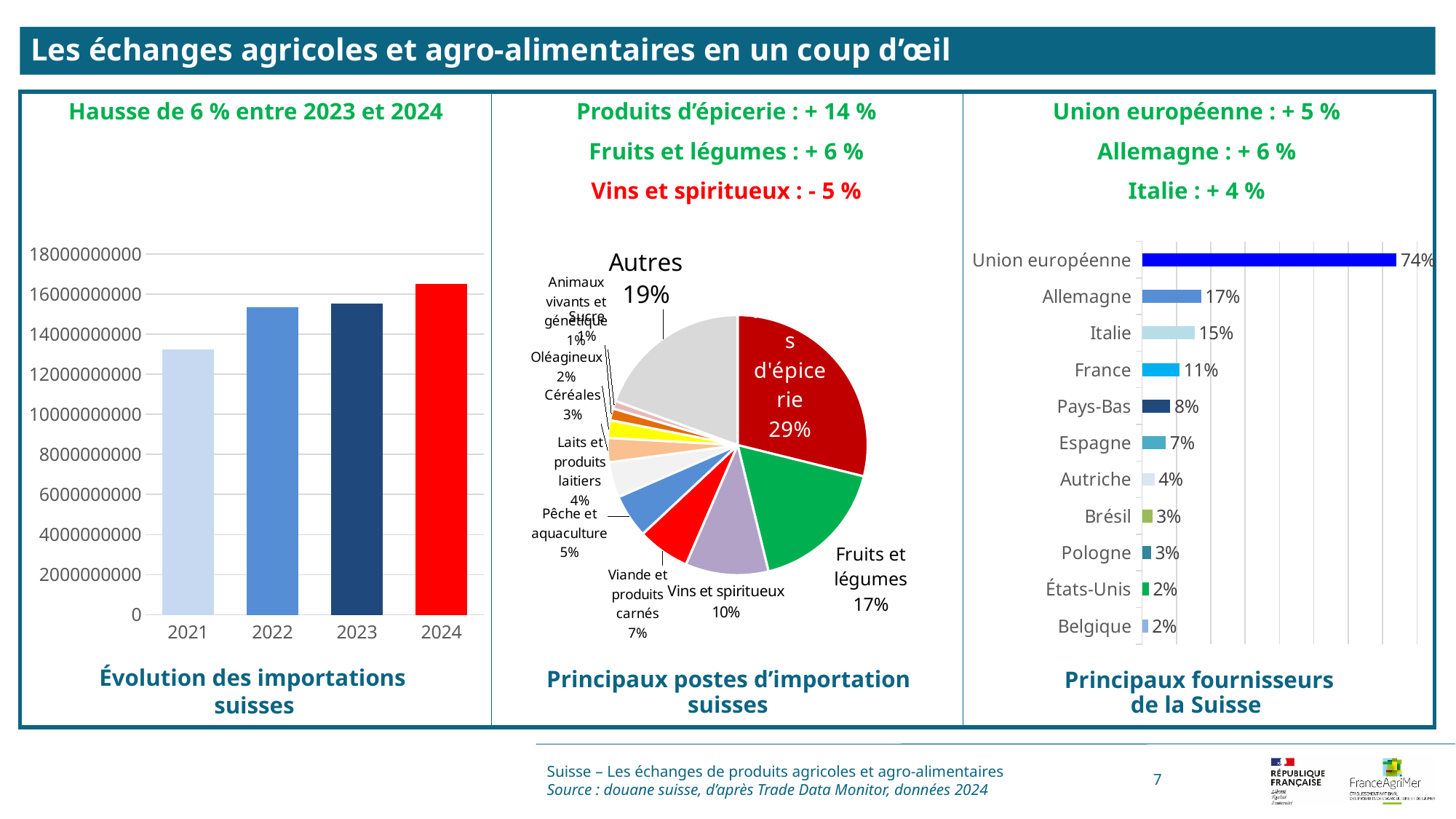
In the chart 'Évolution des importations suisses', is the value for 2021 greater or less than 14000000000? less In the pie chart 'Principaux postes d'importation suisses', what share does Vins et spiritueux have? 10% In the pie chart 'Principaux postes d'importation suisses', which is larger: Viande et produits carnés or Pêche et aquaculture? Viande et produits carnés In the pie chart 'Principaux postes d'importation suisses', which category has the largest share? Produits d'épicerie In the chart 'Évolution des importations suisses', which year has the highest value? 2024 What kind of chart is 'Évolution des importations suisses'? bar chart In the chart 'Principaux fournisseurs de la Suisse', what is the value for Pays-Bas? 8% In the chart 'Principaux fournisseurs de la Suisse', what is the difference between the values for Union européenne and Italie? 59% In the chart 'Évolution des importations suisses', do the values rise or fall from 2021 to 2024? rise In the pie chart 'Principaux postes d'importation suisses', what is the share for Céréales? 3% In the chart 'Principaux fournisseurs de la Suisse', how many countries or regions are listed? 11 In the chart 'Principaux fournisseurs de la Suisse', what is the value for Allemagne? 17%